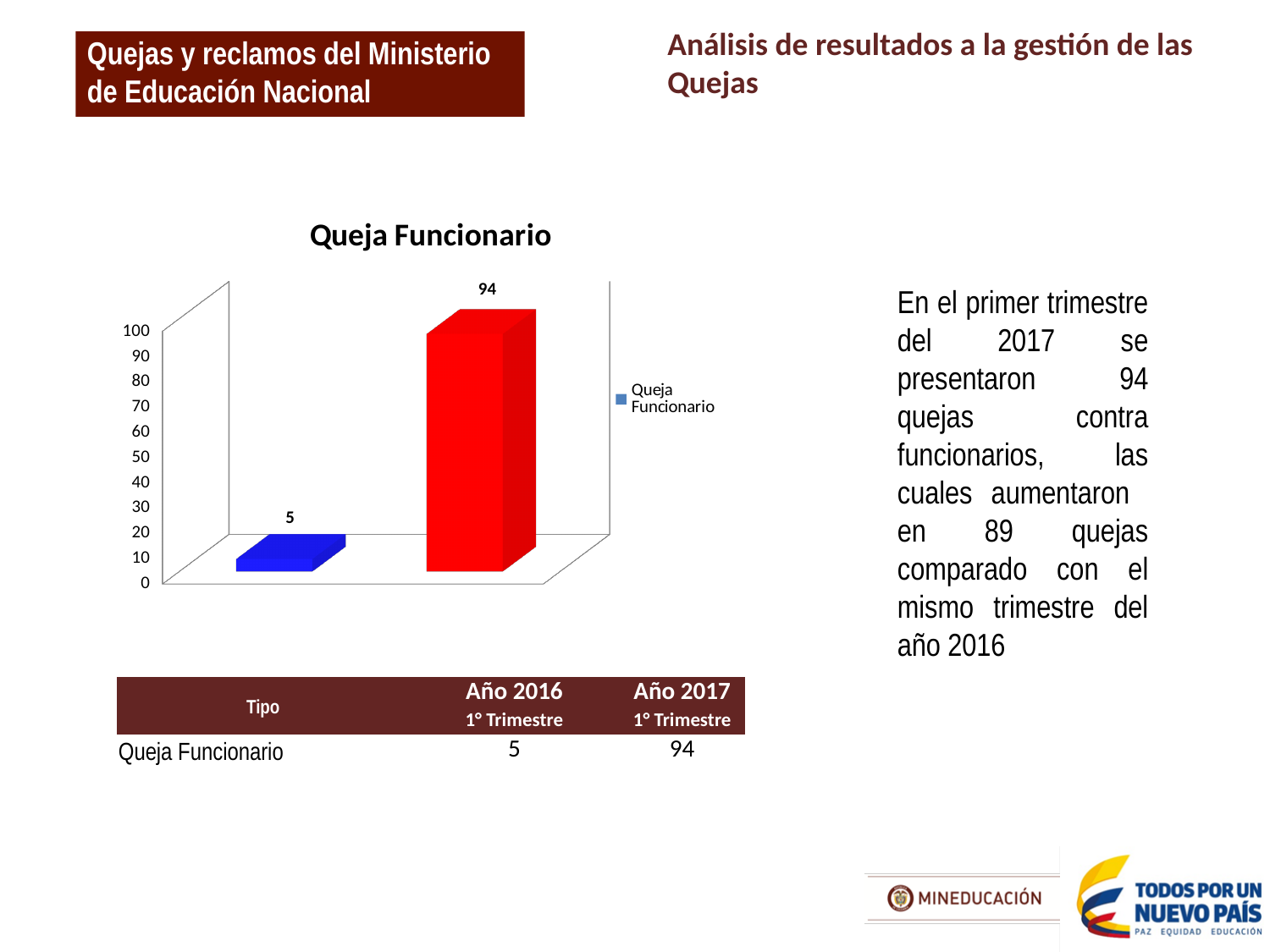
Is the value of the red bar greater or less than 50? greater How many bars are plotted in the chart? 2 Do the values rise or fall from the left bar to the right bar in the chart? rise What is the value shown on the blue bar in the chart? 5 Is the value of the blue bar greater or less than 10? less What is the title of the chart? Queja Funcionario What is the value shown on the red bar in the chart? 94 Which bar is taller in the chart, the blue one or the red one? the red one How many series does the chart legend list? 1 What is the name of the series in the chart legend? Queja Funcionario What type of chart is shown on the slide? bar chart What is the difference between the two bar values in the chart? 89